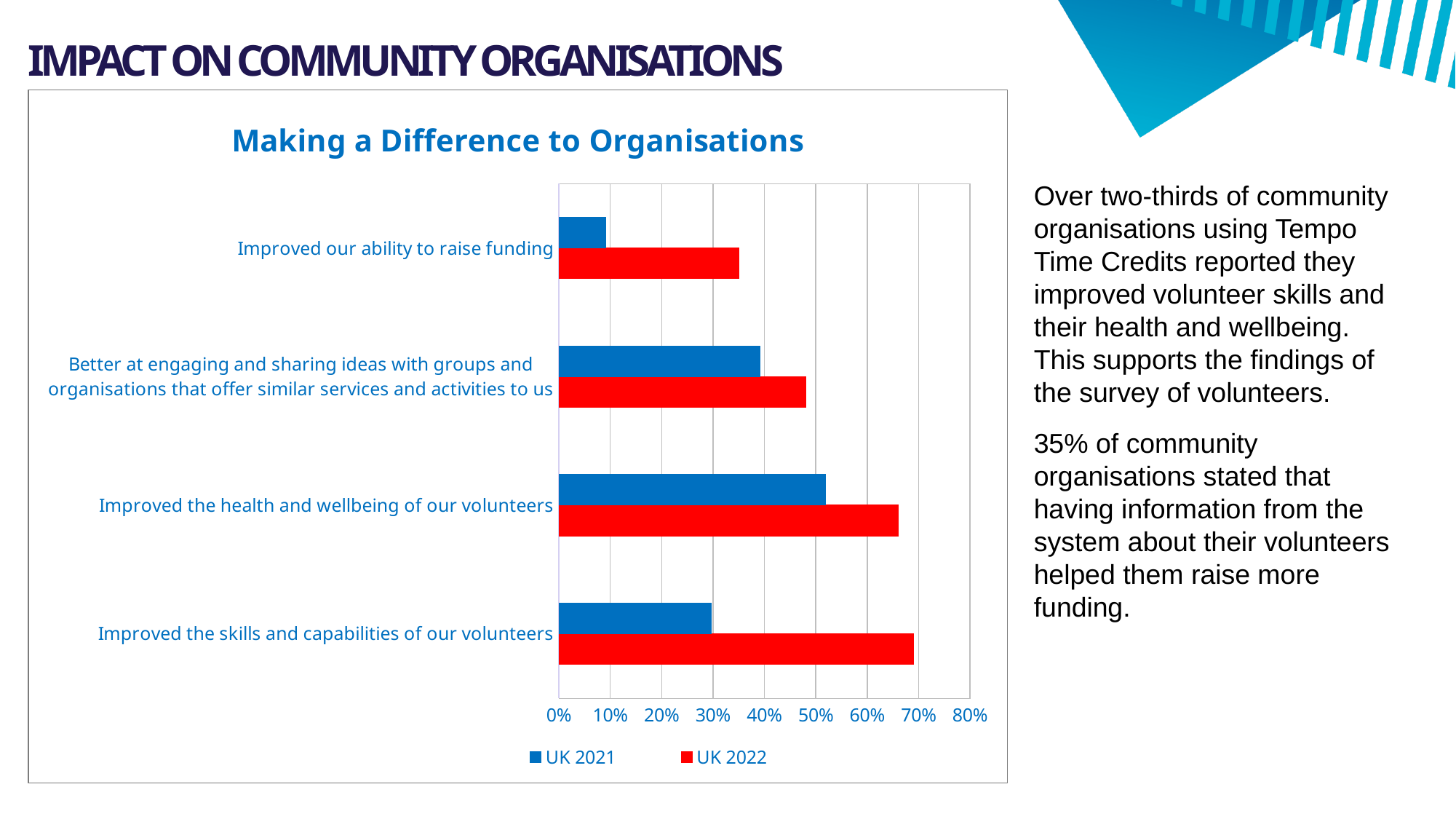
Is the UK 2021 value for 'Improved the skills and capabilities of our volunteers' greater or less than 40%? less How many categories are shown on the chart? 4 Is the UK 2022 value for 'Improved the skills and capabilities of our volunteers' greater or less than 60%? greater For the UK 2021 series, which category has the highest value? Improved the health and wellbeing of our volunteers For the UK 2022 series, which category has the lowest value? Improved our ability to raise funding How many series does the legend list? 2 For the UK 2021 series, which category has the lowest value? Improved our ability to raise funding Which colour represents the UK 2022 series? Red Is the UK 2021 value for 'Improved our ability to raise funding' greater or less than 20%? less For 'Improved the health and wellbeing of our volunteers', which series has the larger value, UK 2021 or UK 2022? UK 2022 What kind of chart is shown on the slide? Bar chart What is the title of the chart? Making a Difference to Organisations